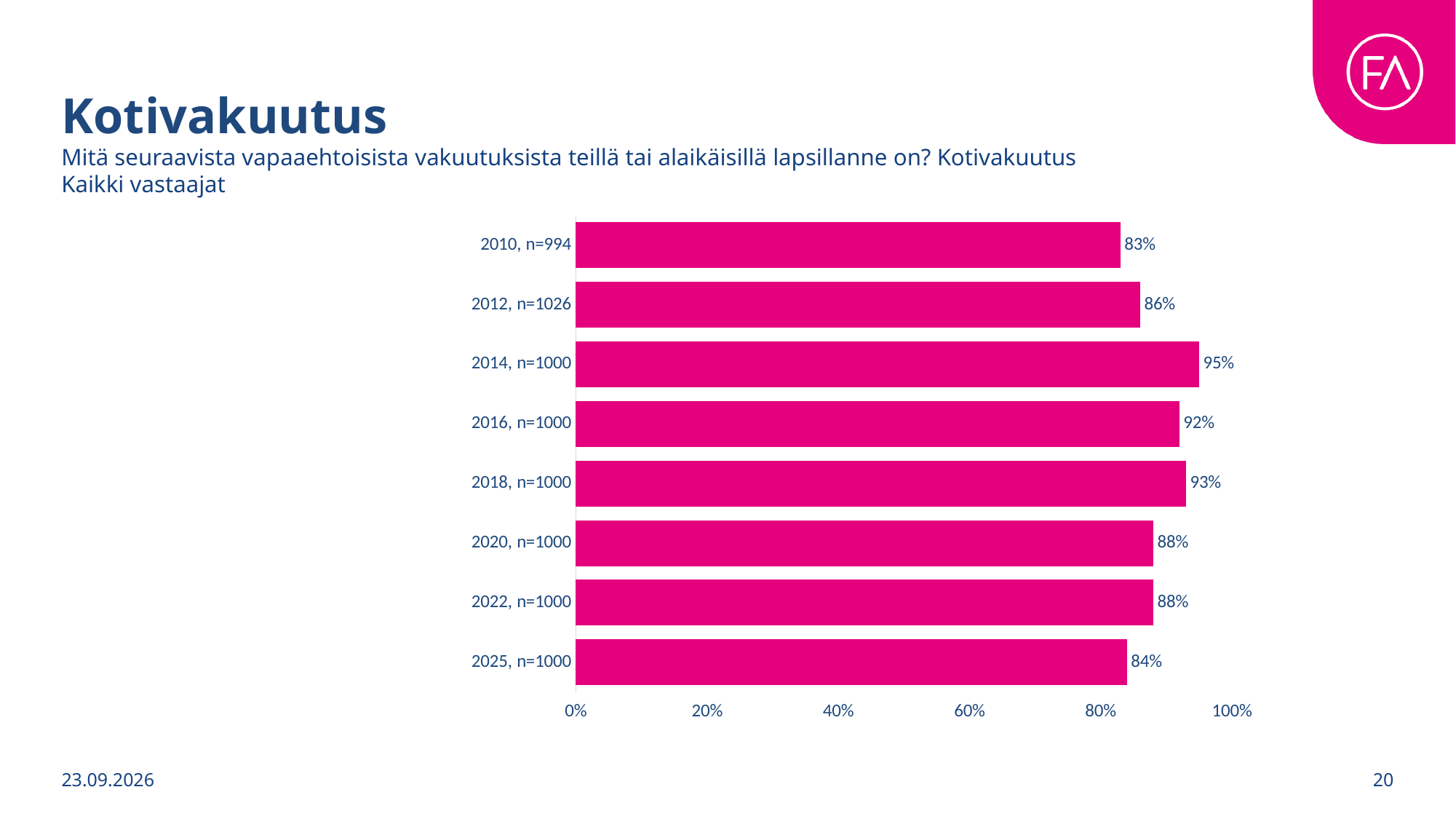
Which is larger, the value for 2016, n=1000 or the value for 2020, n=1000? 2016, n=1000 What is the title of the slide? Kotivakuutus What is the value for 2014, n=1000? 95% What kind of chart is shown on the slide? Bar chart How many categories are shown in the chart? 8 Which category has the lowest value? 2010, n=994 What is the value for 2025, n=1000? 84% What is the difference between the values for 2012, n=1026 and 2010, n=994? 3% What is the value for 2010, n=994? 83% Which category has the highest value? 2014, n=1000 What is the difference between the values for 2014, n=1000 and 2025, n=1000? 11% Is the value for 2018, n=1000 greater or less than 80%? greater